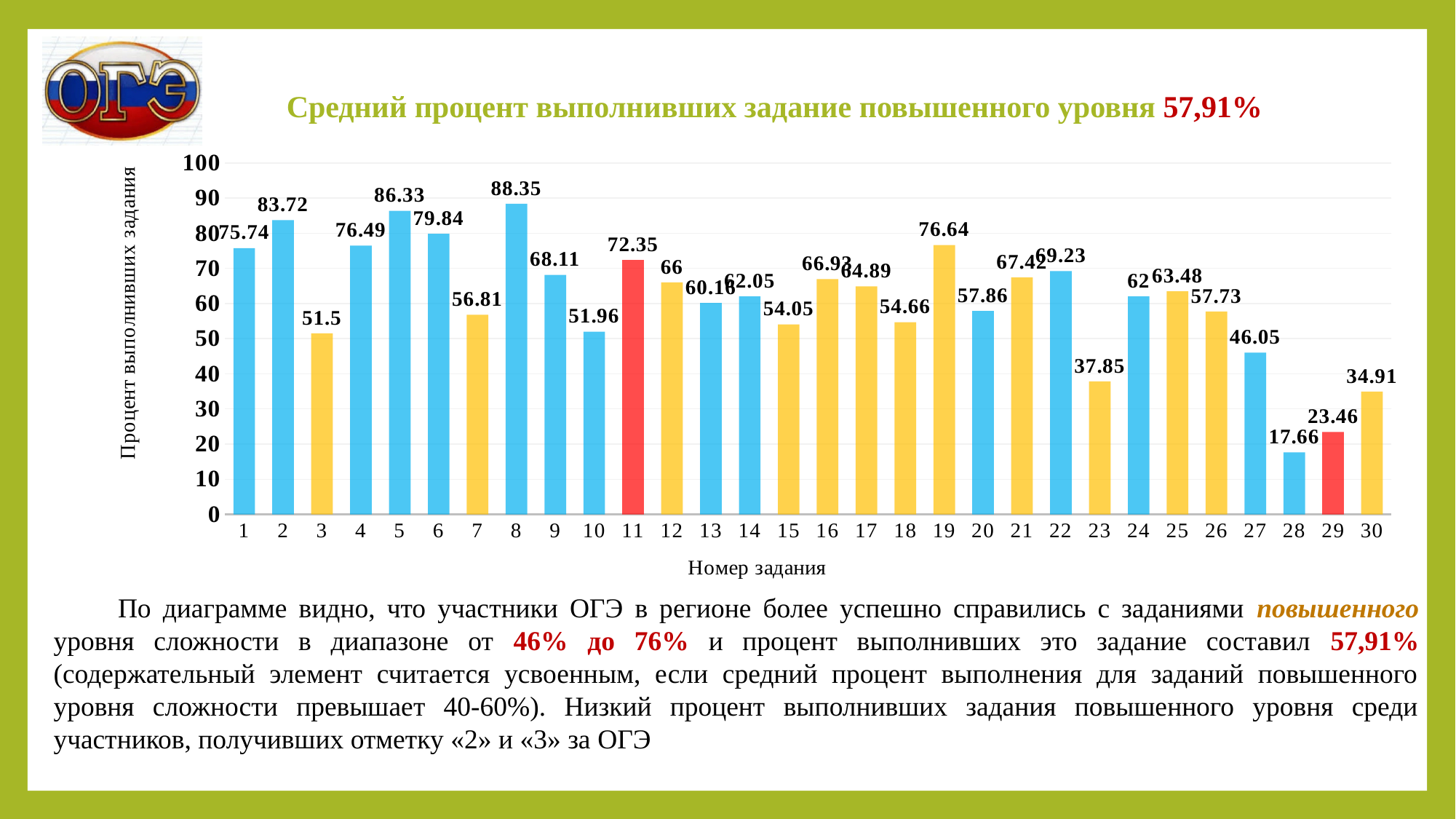
Is the value for task 23 greater or less than 40? less Which task has the highest value? 8 Which task has the lowest value? 28 What is the value for task 11? 72.35 What is the value for task 30? 34.91 How many tasks (categories) are plotted on the x axis? 30 What is the value for task 19? 76.64 Which has the larger value, task 5 or task 6? task 5 What is the title of the x axis? Номер задания What is the difference between the values for task 8 and task 28? 70.69 What is the difference between the values for task 2 and task 3? 32.22 What type of chart is shown on the slide? bar chart